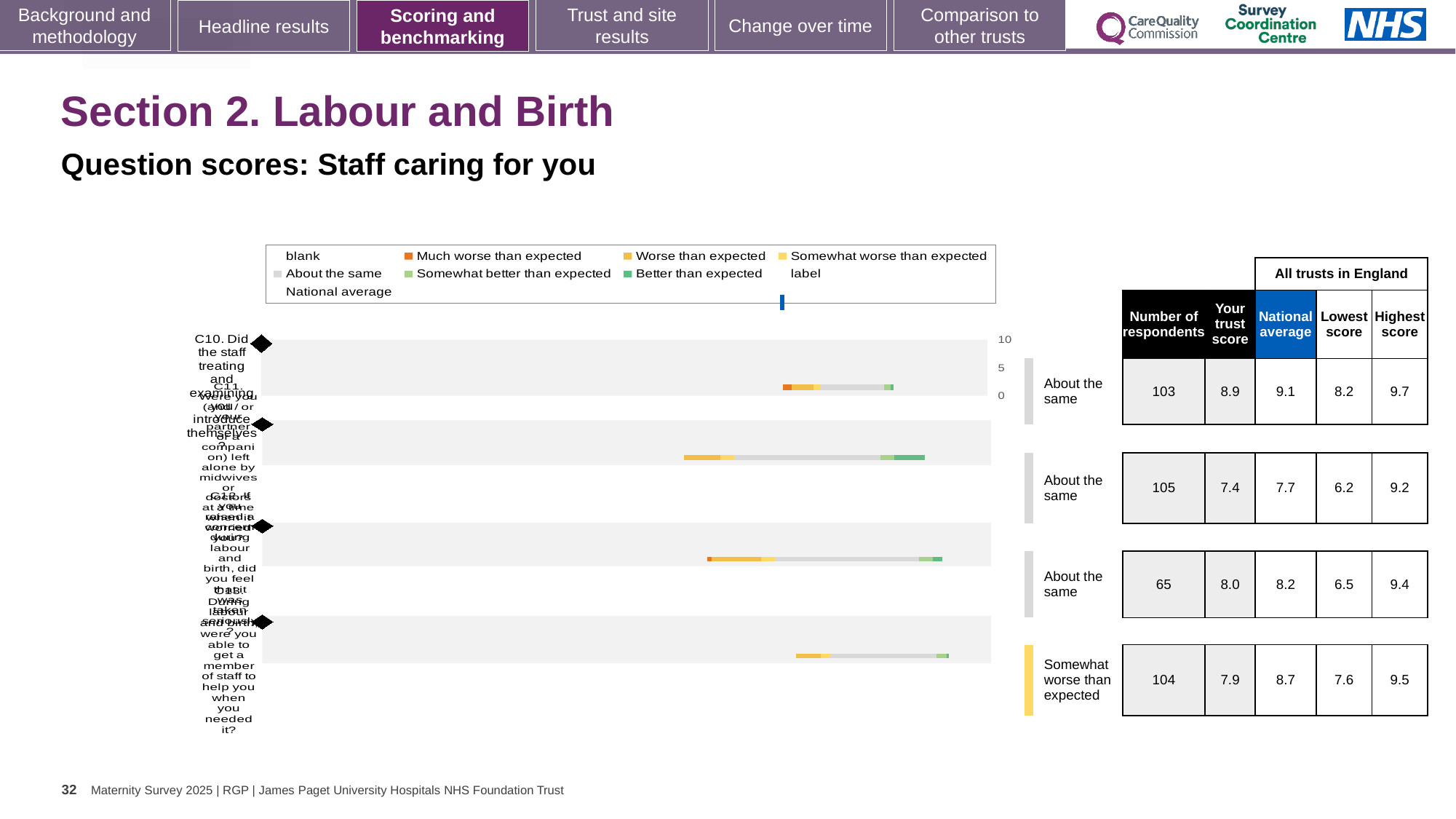
In the table beside the chart, what is 'Your trust score' for the bottom (fourth) row? 7.9 What kind of chart is shown on the slide? bar chart How many question rows (bars) does the chart show? 4 In the chart legend, what colour represents 'Much worse than expected'? orange In the chart legend, what colour represents 'Better than expected'? green In the table beside the chart, which row has the lowest 'Your trust score'? the second row, 7.4 In the table beside the chart, what is the highest score for the third row? 9.4 In the table beside the chart, what is the number of respondents for the top row (C10)? 103 Which row is rated 'Somewhat worse than expected' rather than 'About the same'? the bottom (fourth) row For the second row, which is larger: 'Your trust score' or the national average? national average For the bottom (fourth) row, what is the difference between the national average and 'Your trust score'? 0.8 In the table beside the chart, which row has the highest 'Your trust score'? the top row (C10), 8.9